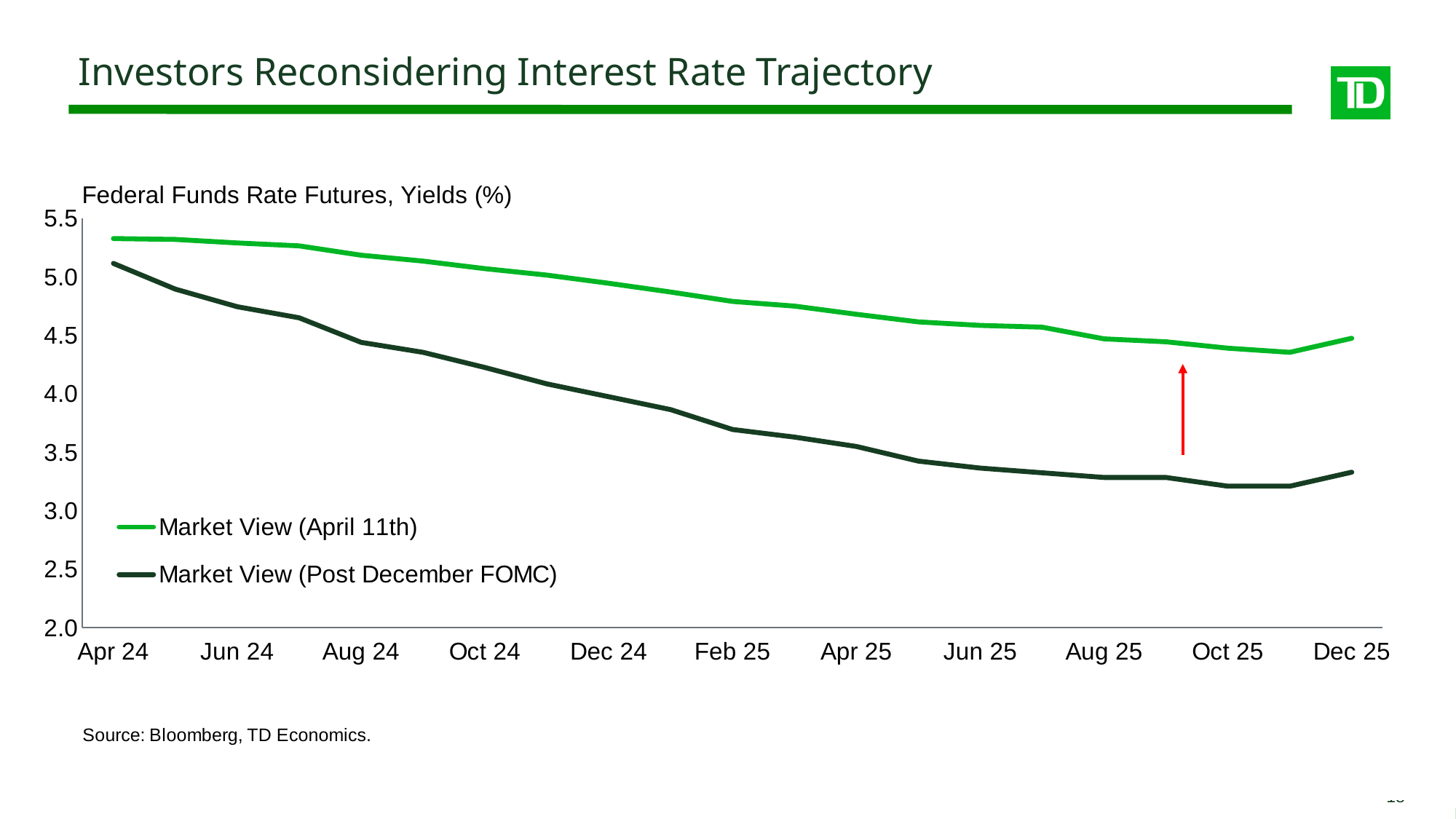
Does the Market View (April 11th) line rise or fall from Apr 24 to Oct 25? Fall What is the title of the chart? Federal Funds Rate Futures, Yields (%) At Dec 25, which series is higher: Market View (April 11th) or Market View (Post December FOMC)? Market View (April 11th) How many series does the legend list? 2 Is the value for Market View (Post December FOMC) at Dec 25 greater or less than 3.5? less Is the value for Market View (April 11th) at Dec 25 greater or less than 4.0? greater Is the value for Market View (Post December FOMC) at Oct 24 greater or less than 4.5? less How many month labels are shown on the x axis? 11 Which series is drawn in the darker green line? Market View (Post December FOMC) At Apr 24, which series is higher: Market View (April 11th) or Market View (Post December FOMC)? Market View (April 11th) What kind of chart is shown on the slide? Line chart